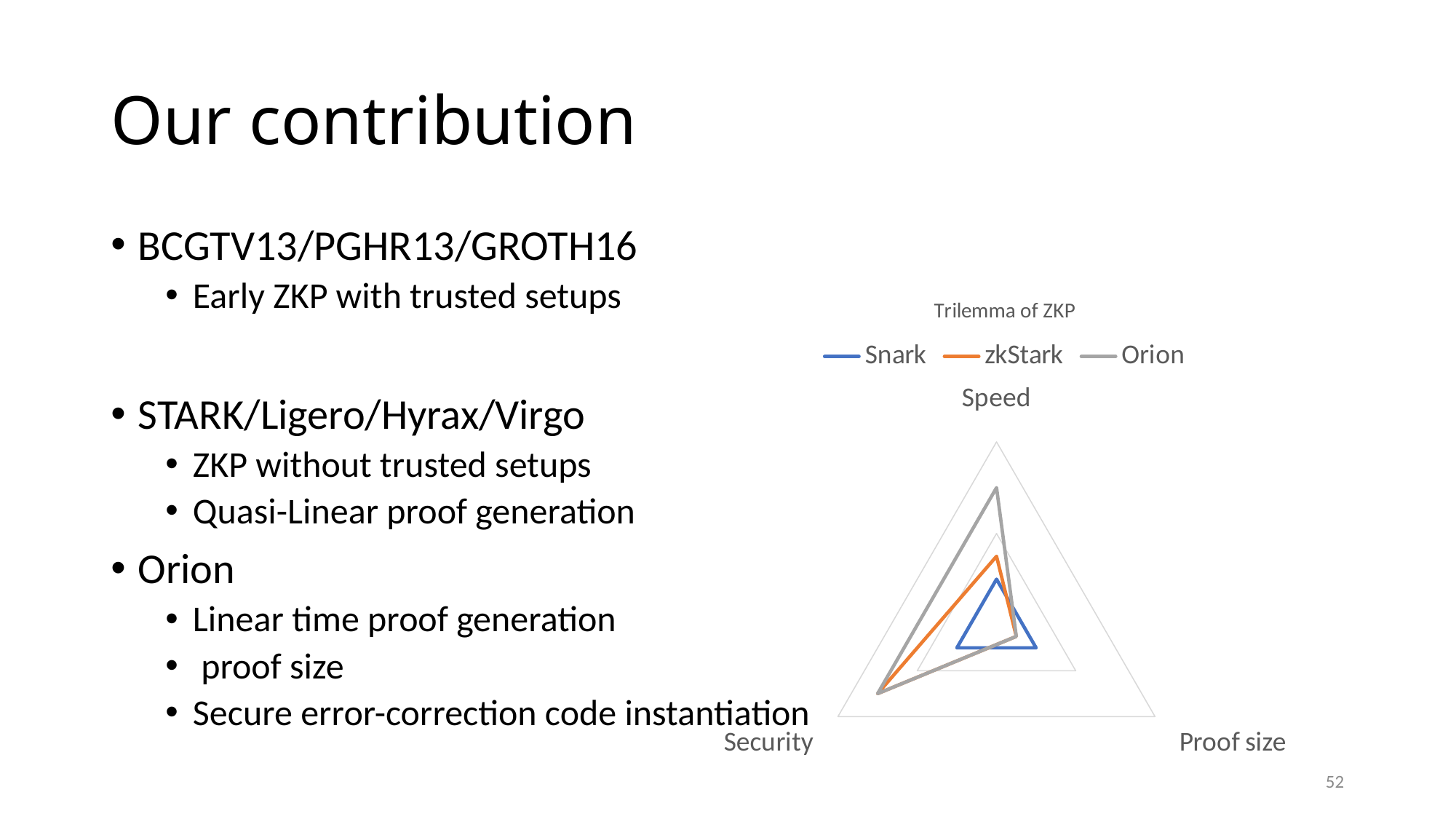
What kind of chart is shown on the slide? radar chart Which series are listed in the legend of the "Trilemma of ZKP" chart? Snark, zkStark, Orion How many axes (categories) does the "Trilemma of ZKP" radar chart have? 3 In the "Trilemma of ZKP" chart, which series has the highest value on the Speed axis? Orion What is the title of the chart on the slide? Trilemma of ZKP In the "Trilemma of ZKP" chart, which is larger on the Proof size axis: Snark or Orion? Snark In the "Trilemma of ZKP" chart, which series has the lowest value on the Security axis? Snark In the "Trilemma of ZKP" chart, which is larger on the Speed axis: zkStark or Snark? zkStark In the "Trilemma of ZKP" chart, which series has the lowest value on the Speed axis? Snark How many series does the legend of the "Trilemma of ZKP" chart list? 3 In the "Trilemma of ZKP" chart, which series has the lowest value on the Proof size axis? zkStark and Orion (tied) In the "Trilemma of ZKP" chart, which is larger on the Security axis: Orion or Snark? Orion